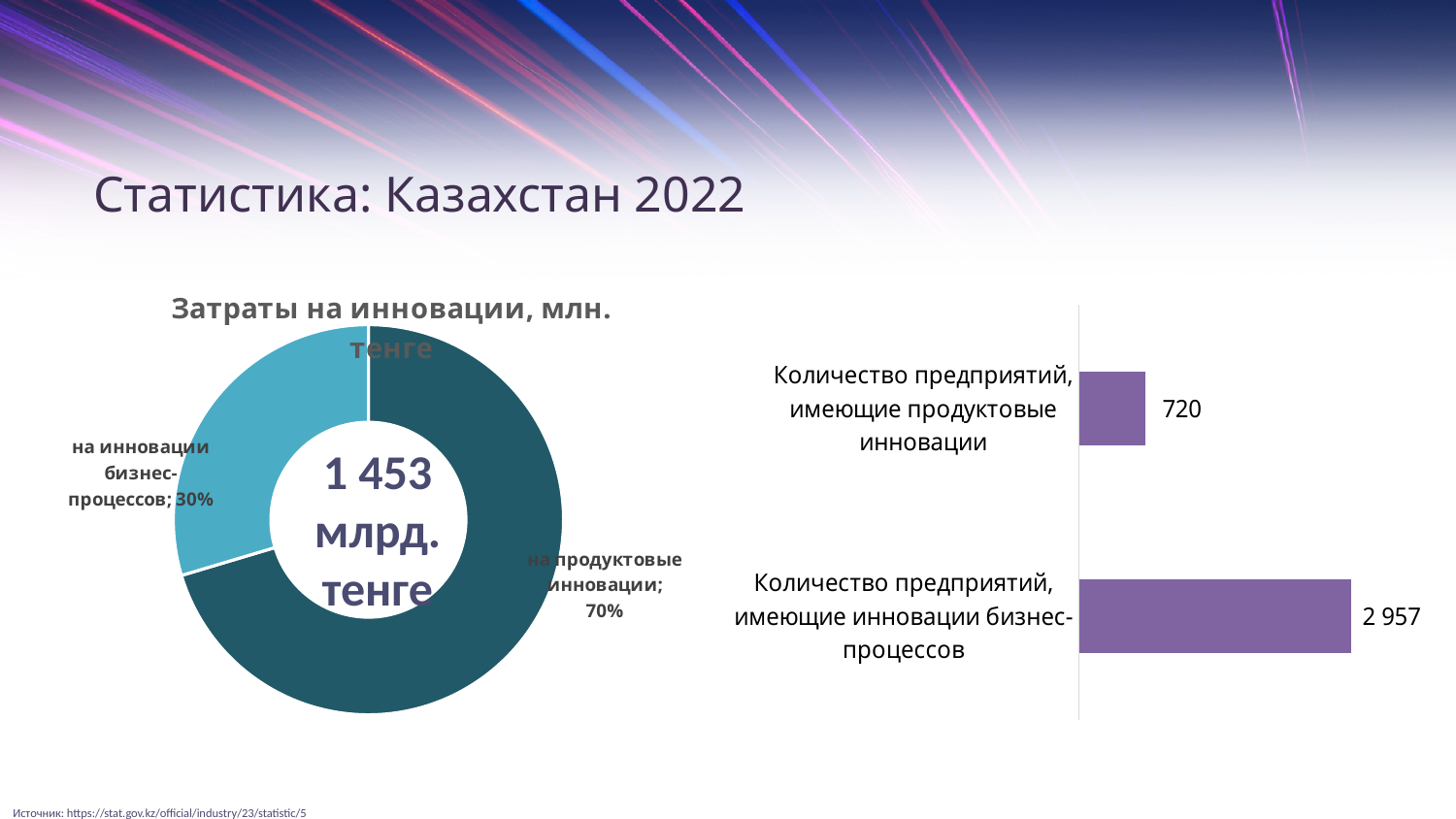
What kind of chart is the chart on the right of the slide? Bar chart In the doughnut chart on the left, which slice is the smallest? на инновации бизнес-процессов In the doughnut chart on the left, which slice is the largest? на продуктовые инновации In the bar chart on the right, what is the value for "Количество предприятий, имеющие инновации бизнес-процессов"? 2 957 What text is shown in the centre of the doughnut chart on the left? 1 453 млрд. тенге In the bar chart on the right, what is the difference between the two bar values? 2 237 In the bar chart on the right, which category has the higher value? Количество предприятий, имеющие инновации бизнес-процессов In the doughnut chart titled "Затраты на инновации, млн. тенге", what share is labelled for "на инновации бизнес-процессов"? 30% What kind of chart is the chart on the left of the slide? Doughnut chart In the bar chart on the right, what is the value for "Количество предприятий, имеющие продуктовые инновации"? 720 In the doughnut chart titled "Затраты на инновации, млн. тенге", what share is labelled for "на продуктовые инновации"? 70% In the doughnut chart on the left, how many slices are there? 2